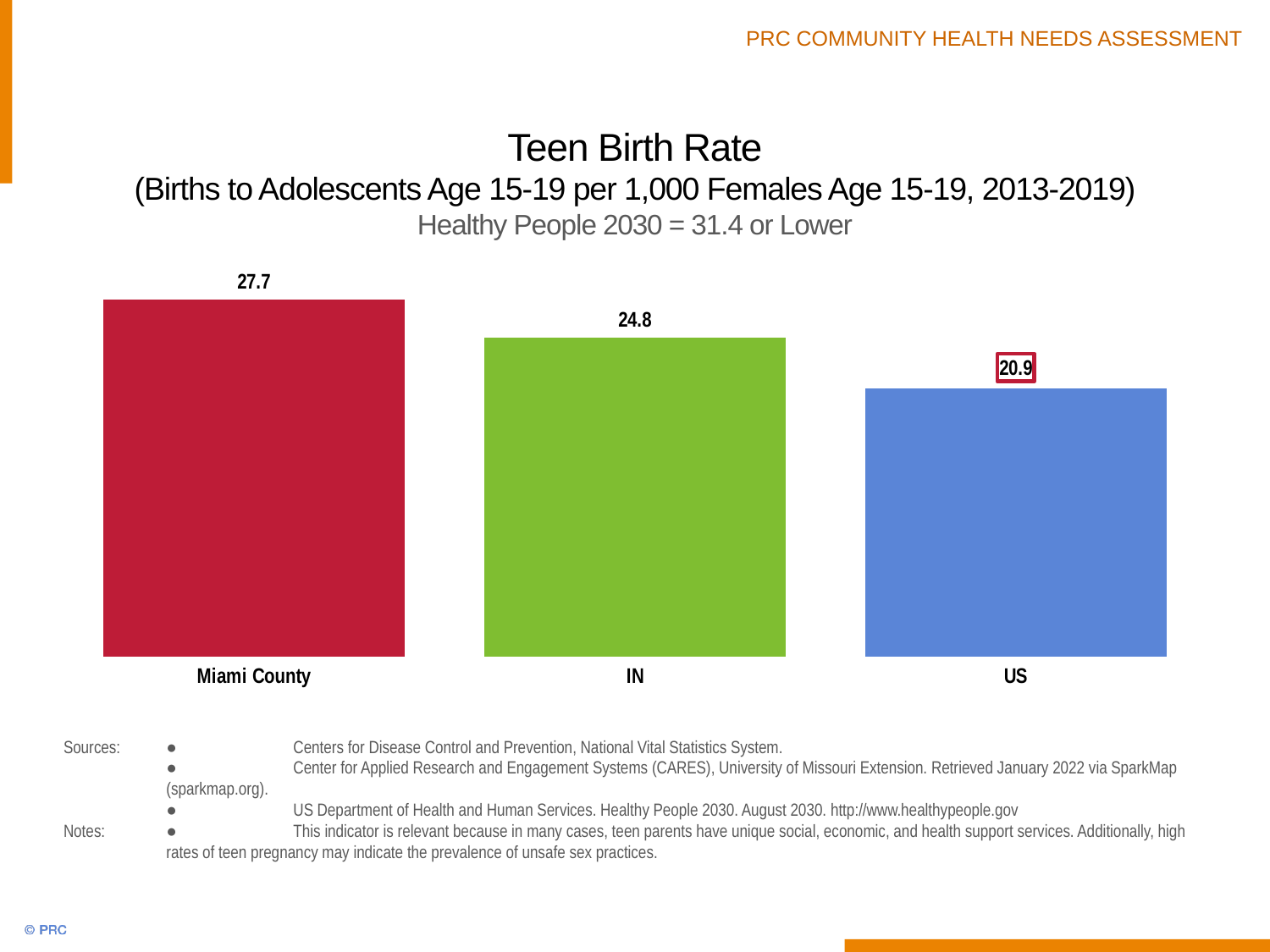
Which has a higher teen birth rate, IN or US? IN Which category has the lowest teen birth rate? US How many categories are shown in the chart? 3 What is the teen birth rate for US? 20.9 What is the teen birth rate for IN? 24.8 What is the difference between the teen birth rate for Miami County and for IN? 2.9 Do the values rise or fall from left to right across the chart? Fall What is the Healthy People 2030 target stated in the chart subtitle? 31.4 or Lower Which category has the highest teen birth rate? Miami County What is the teen birth rate for Miami County? 27.7 What kind of chart is shown on the slide? Bar chart What is the difference between the teen birth rate for Miami County and for US? 6.8